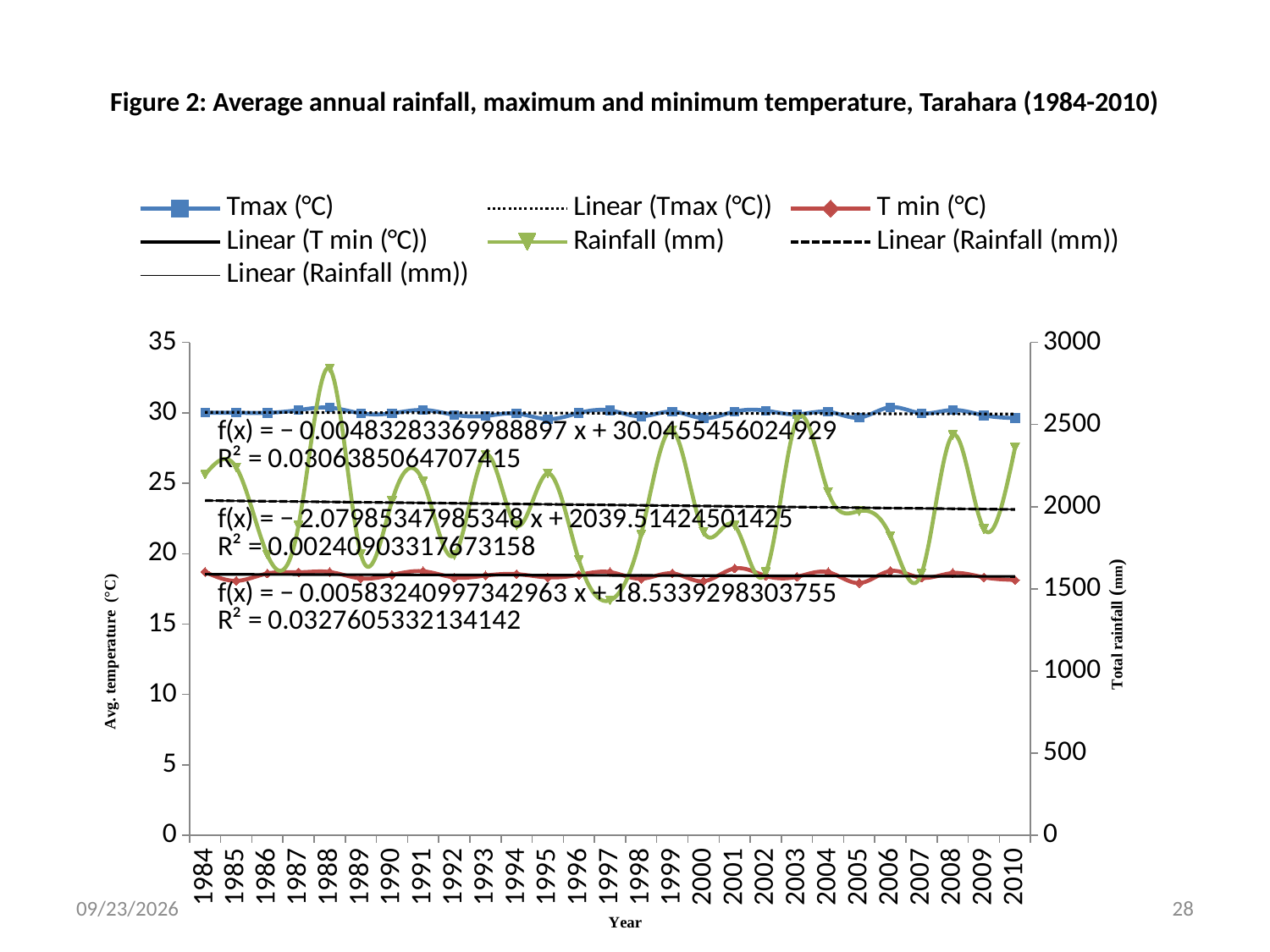
In which year is Rainfall (mm) highest? 1988 Is the T min (°C) value for 2001 greater or less than 20? less Is the Rainfall (mm) value for 2003 greater or less than 2000? greater What is the title of the right-hand vertical axis? Total rainfall (mm) Is the Rainfall (mm) value for 1988 greater or less than 2500? greater Which is larger in 1990, Tmax (°C) or T min (°C)? Tmax (°C) What kind of chart is shown on the slide? line chart In which year is Rainfall (mm) lowest? 1997 How many years are plotted along the x axis? 27 How many entries does the legend list? 7